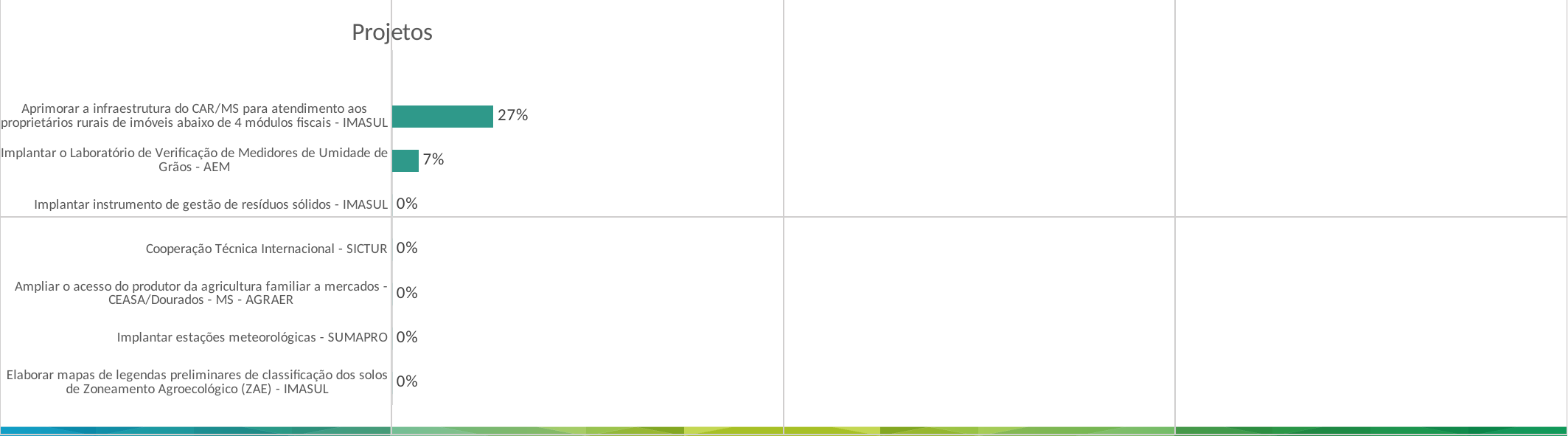
What kind of chart is shown on the slide? Bar chart Which is larger: the value for 'Implantar o Laboratório de Verificação de Medidores de Umidade de Grãos - AEM' or 'Implantar instrumento de gestão de resíduos sólidos - IMASUL'? Implantar o Laboratório de Verificação de Medidores de Umidade de Grãos - AEM What is the value for 'Implantar o Laboratório de Verificação de Medidores de Umidade de Grãos - AEM'? 7% Which project has the highest value? Aprimorar a infraestrutura do CAR/MS para atendimento aos proprietários rurais de imóveis abaixo de 4 módulos fiscais - IMASUL What is the title of the chart? Projetos What is the value for 'Elaborar mapas de legendas preliminares de classificação dos solos de Zoneamento Agroecológico (ZAE) - IMASUL'? 0% How many projects are listed in the chart? 7 What is the value for 'Aprimorar a infraestrutura do CAR/MS para atendimento aos proprietários rurais de imóveis abaixo de 4 módulos fiscais - IMASUL'? 27% What is the difference between the value for the CAR/MS infrastructure project (IMASUL) and the grain moisture meter laboratory project (AEM)? 20% How many projects have a value of 0%? 5 What is the value for 'Cooperação Técnica Internacional - SICTUR'? 0% What is the value for 'Implantar estações meteorológicas - SUMAPRO'? 0%